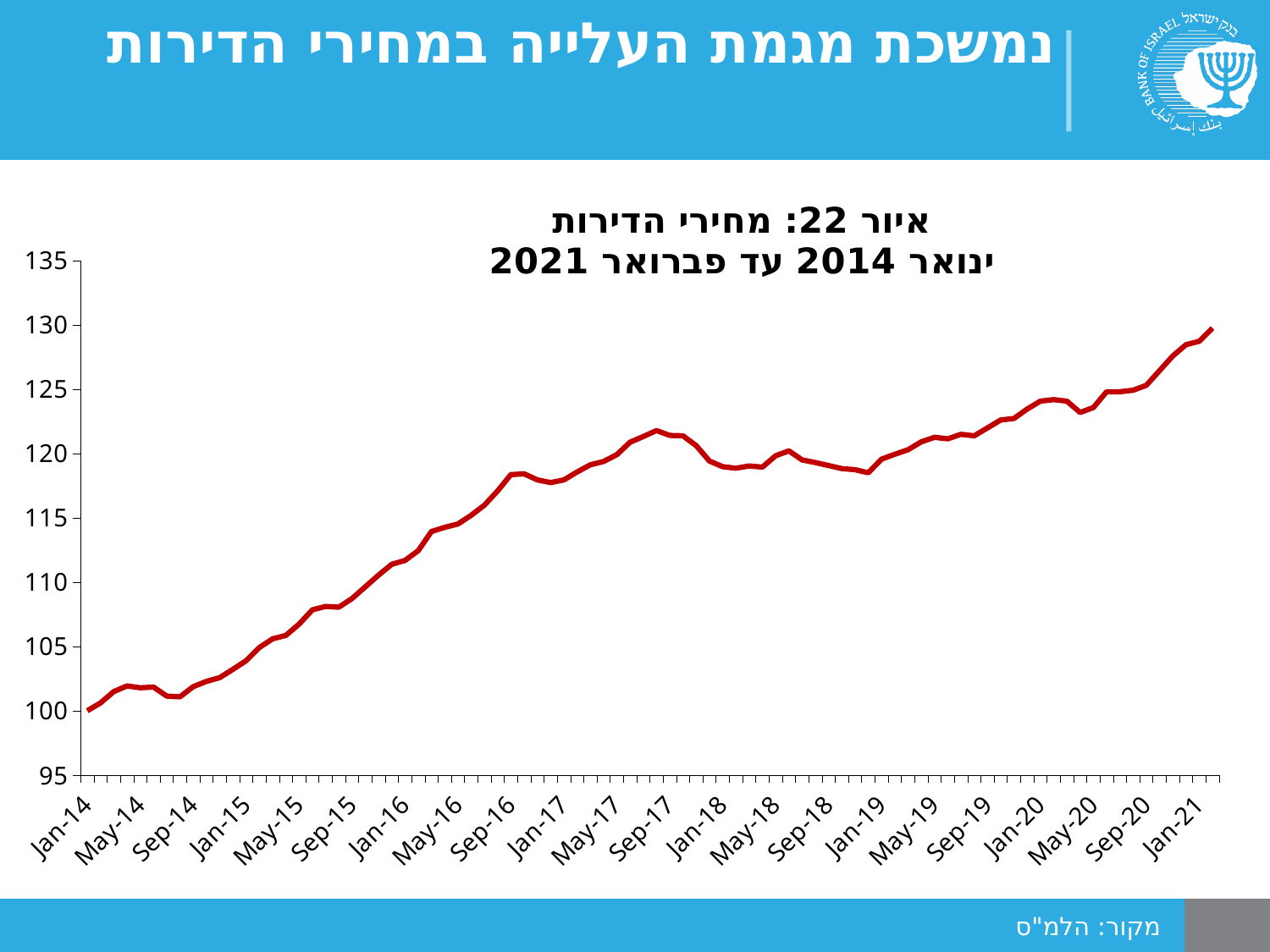
Is the value for Jan-21 greater or less than 125? greater How many data series are plotted on the chart? 1 What is the value of the index at Jan-14? 100 Is the value for Jan-16 greater or less than 110? greater Do the values generally rise or fall from Jan-14 to Jan-21? rise Is the value for Sep-17 greater or less than 120? greater What is the title of the chart? איור 22: מחירי הדירות ינואר 2014 עד פברואר 2021 What kind of chart is shown on the slide? line chart At which labelled point on the x axis is the index lowest? Jan-14 Which is larger, the value at Jan-18 or the value at Jan-20? Jan-20